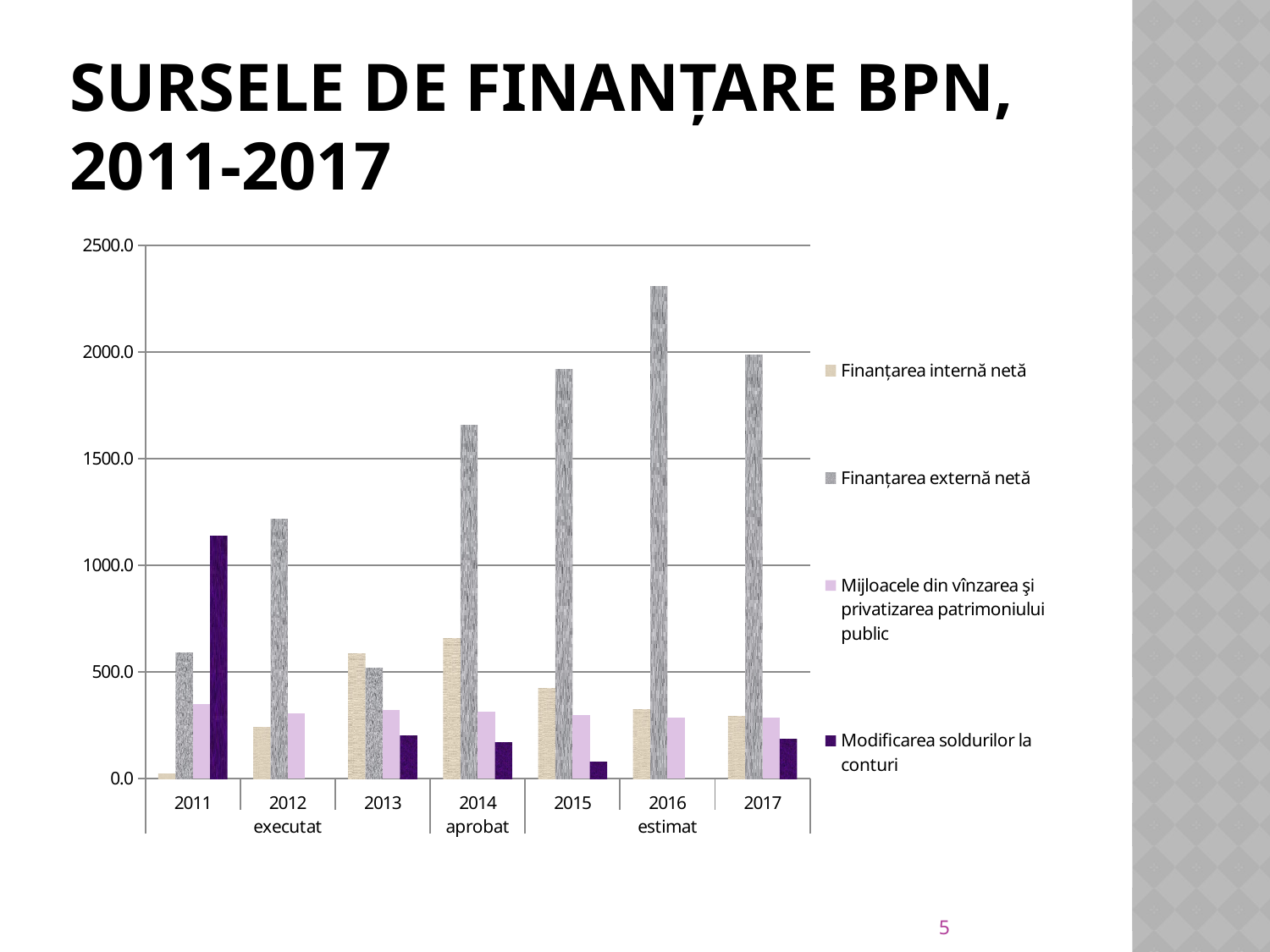
How many years are shown on the x axis? 7 Is the value for Modificarea soldurilor la conturi in 2011 greater or less than 1000.0? greater Which legend entry is shown in dark purple? Modificarea soldurilor la conturi Is the value for Finanțarea externă netă in 2016 greater or less than 2000.0? greater What kind of chart is shown on the slide? bar chart In 2011, which is larger: Finanțarea externă netă or Modificarea soldurilor la conturi? Modificarea soldurilor la conturi Is the value for Finanțarea externă netă in 2014 greater or less than 1500.0? greater How many series does the legend list? 4 In which year is Finanțarea externă netă the highest? 2016 Does Finanțarea externă netă rise or fall from 2012 to 2016? rises In which year is Finanțarea internă netă the lowest? 2011